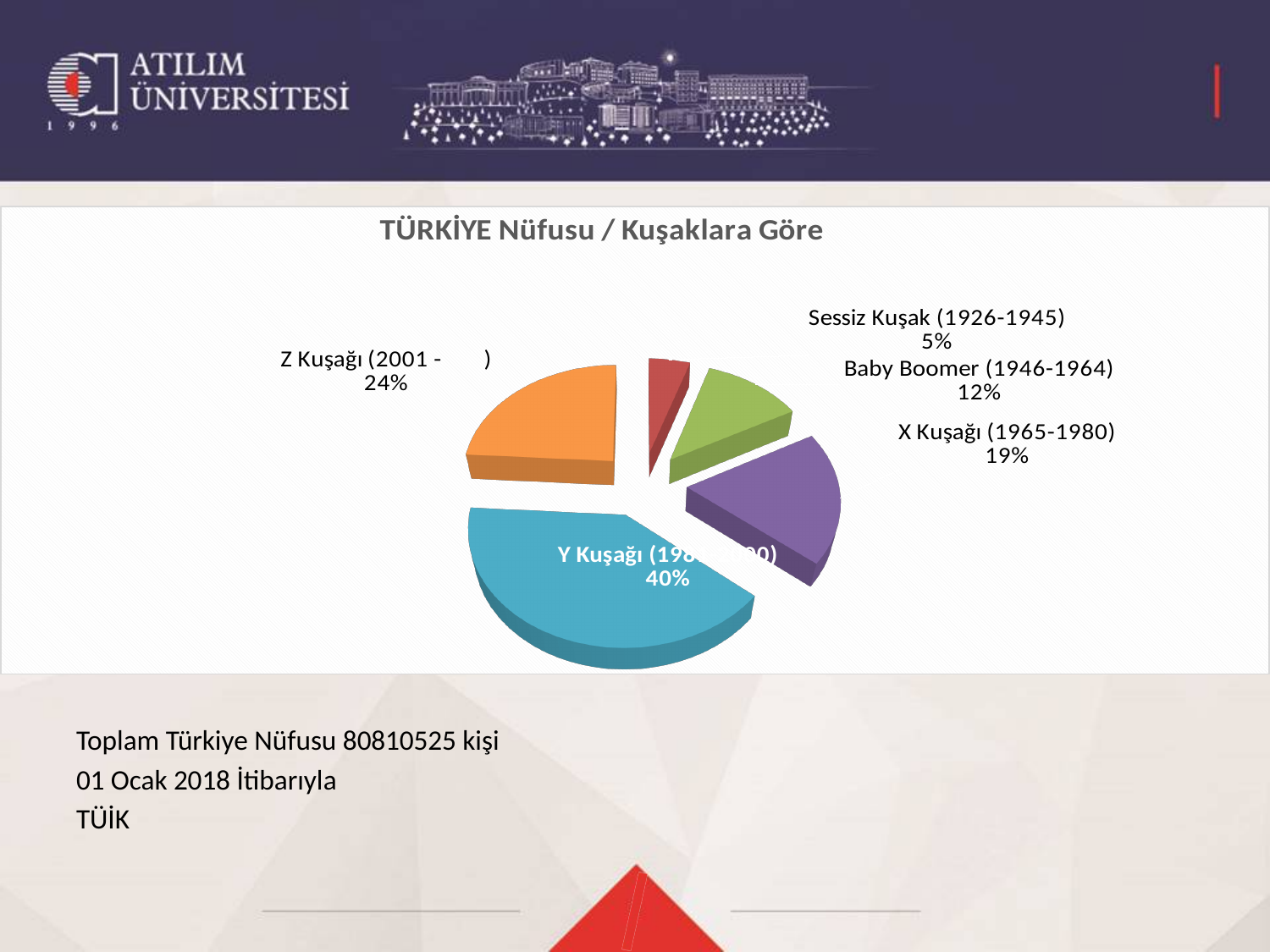
What share of the pie does Z Kuşağı (2001 - ) have? 24% What kind of chart is shown on the slide? pie chart What share of the pie does Baby Boomer (1946-1964) have? 12% How many slices does the pie chart have? 5 What share of the pie does Y Kuşağı have? 40% Which generation has the smallest share of the pie? Sessiz Kuşak (1926-1945) What is the title of the chart? TÜRKİYE Nüfusu / Kuşaklara Göre What share of the pie does X Kuşağı (1965-1980) have? 19% What is the difference in percentage points between Y Kuşağı and Z Kuşağı (2001 - )? 16 What share of the pie does Sessiz Kuşak (1926-1945) have? 5% Which has a larger share, X Kuşağı (1965-1980) or Baby Boomer (1946-1964)? X Kuşağı (1965-1980) Which generation has the largest share of the pie? Y Kuşağı